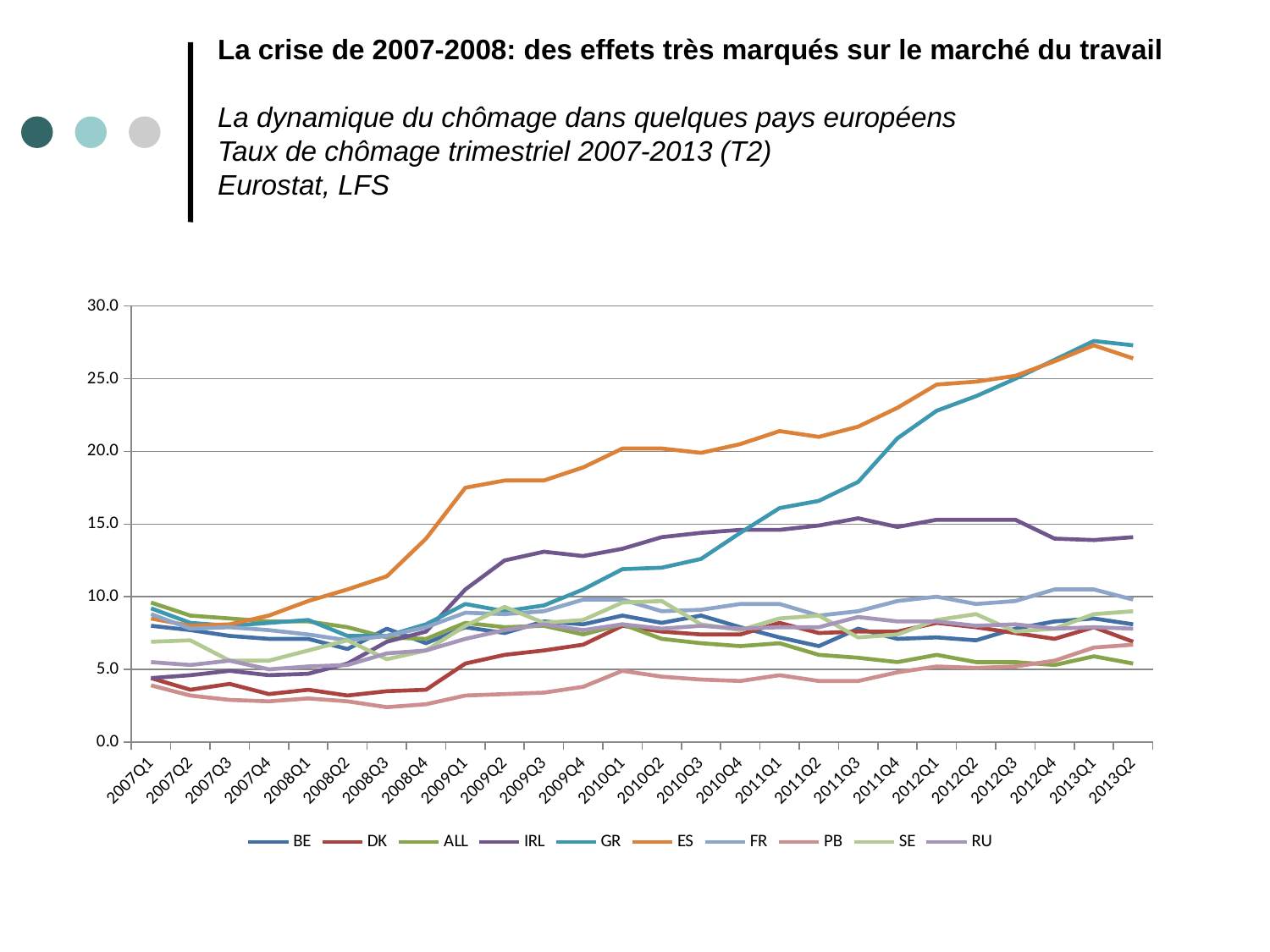
Is the value for ES at 2009Q1 greater or less than 15? greater Which series has the highest value at 2013Q2? GR How many quarters are plotted along the x axis? 26 Is the value for ES at 2013Q2 greater or less than 25? greater Is the value for GR at 2007Q1 greater or less than 10? less How many series does the legend list? 10 What kind of chart is shown on the slide? Line chart At 2010Q1, which series has the larger value, ES or GR? ES Which series has the lowest value at 2013Q2? ALL Which series is drawn in orange in the legend? ES Does the ES series rise or fall overall from 2007Q1 to 2013Q2? Rises